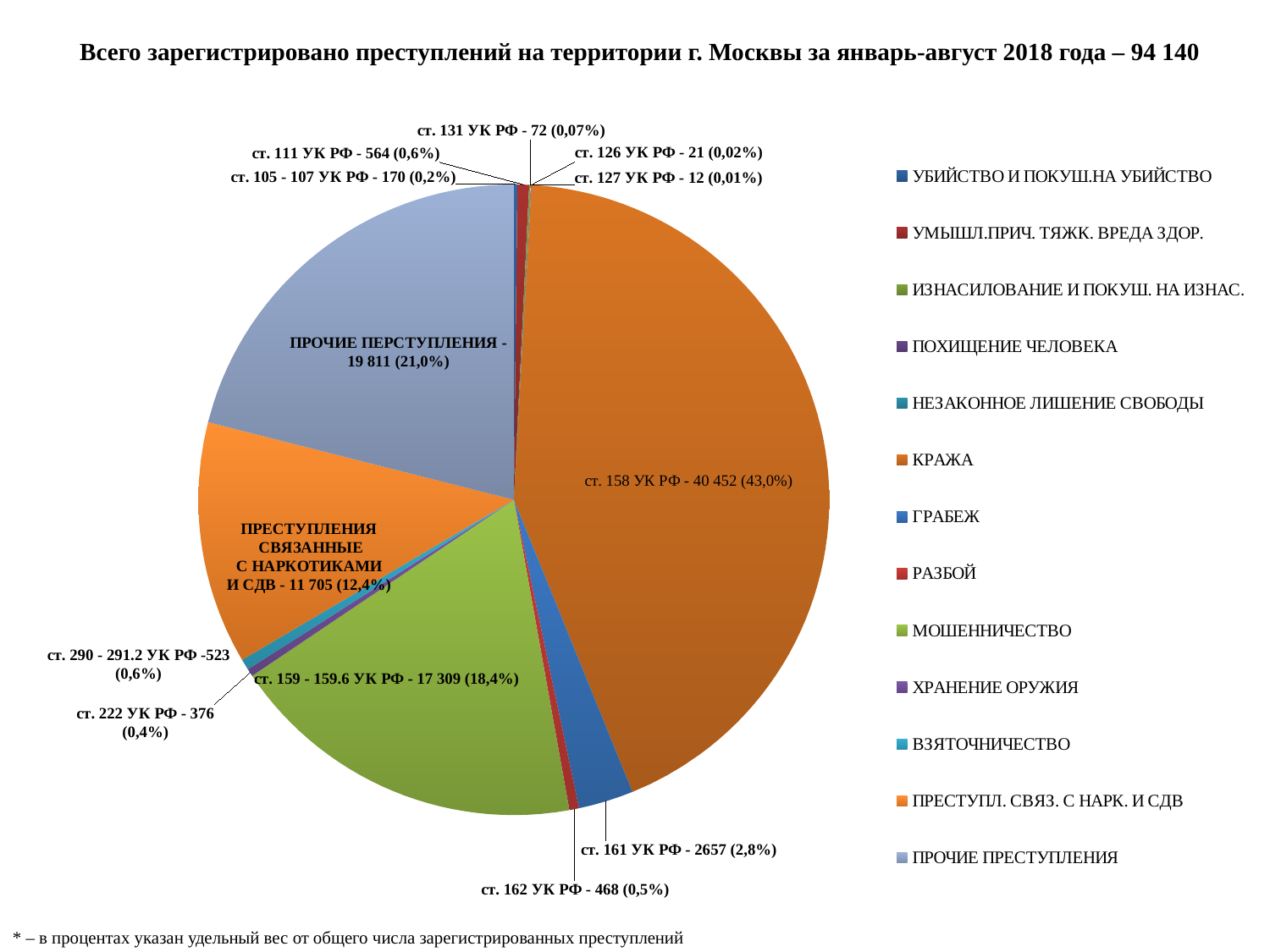
What is the total number of registered crimes stated in the slide title? 94 140 What share of the pie does ст. 158 УК РФ (кража) account for? 43,0% What is the difference between the number of crimes for ст. 161 УК РФ (2657) and ст. 162 УК РФ (468)? 2189 Which category has the largest slice of the pie? ст. 158 УК РФ (кража) Which category has the smallest slice of the pie? ст. 127 УК РФ (незаконное лишение свободы) - 12 How many categories does the legend list? 13 What share of the pie is labelled for ПРОЧИЕ ПРЕСТУПЛЕНИЯ? 21,0% How many crimes are shown for преступления, связанные с наркотиками и СДВ? 11 705 Which is larger: the number of crimes for ст. 111 УК РФ or for ст. 222 УК РФ? ст. 111 УК РФ (564) How many crimes are shown for ст. 159 - 159.6 УК РФ (мошенничество)? 17 309 What type of chart is shown on the slide? pie chart How many crimes are shown for ст. 158 УК РФ (кража)? 40 452